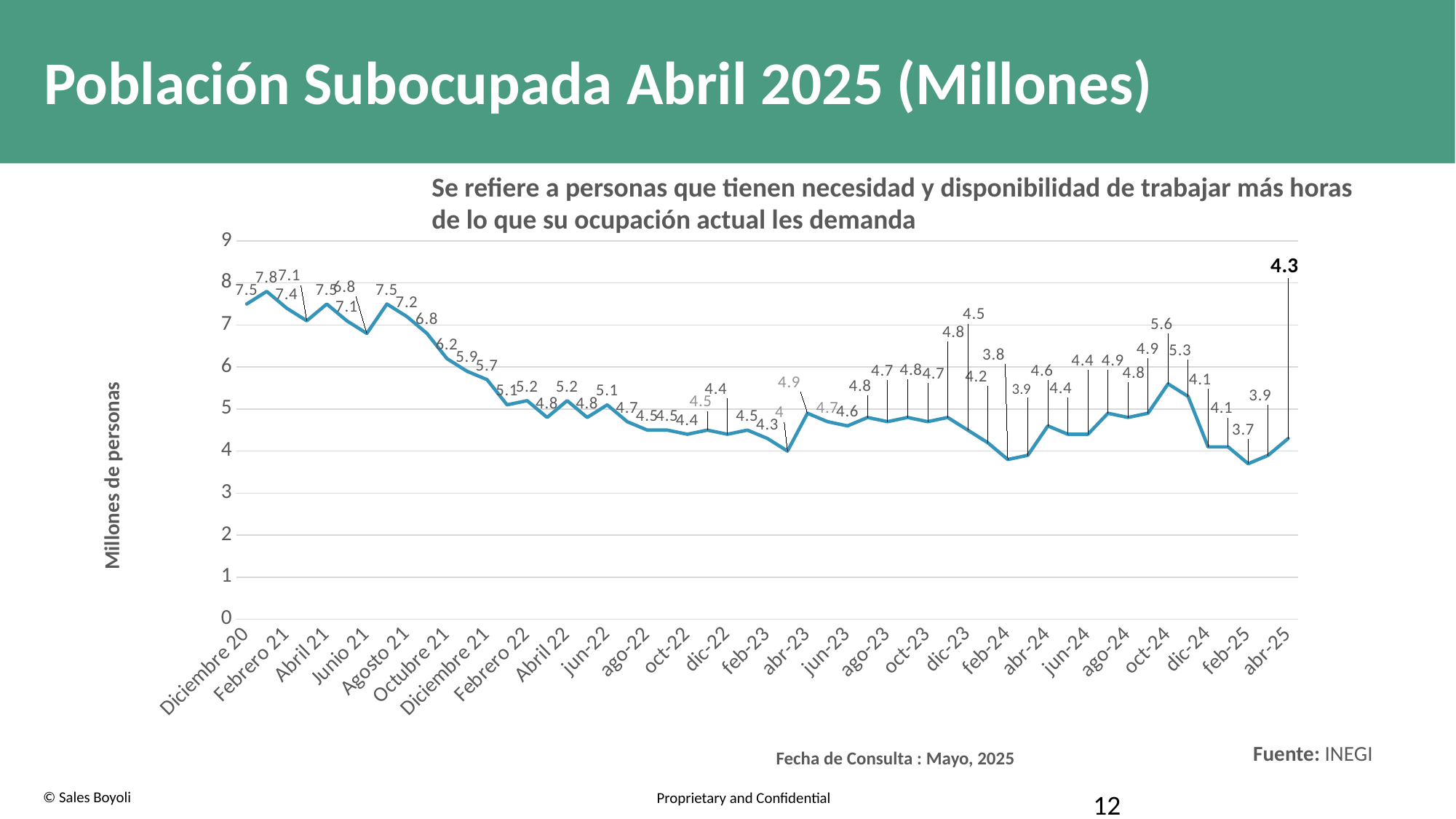
What is the difference between the value for Diciembre 20 and the value for abr-25? 3.2 What is the value for abr-25? 4.3 Which month has the lowest value on the chart? feb-25 What is the value for oct-24? 5.6 Is the value for abr-25 greater or less than 5? less Which is larger, the value for oct-24 or the value for abr-25? oct-24 What is the highest value plotted on the chart? 7.8 Overall, do the values rise or fall from Diciembre 20 to abr-25? fall What is the label of the vertical axis? Millones de personas What is the value for Diciembre 20? 7.5 What source is cited for the chart data? INEGI What kind of chart is shown on the slide? line chart